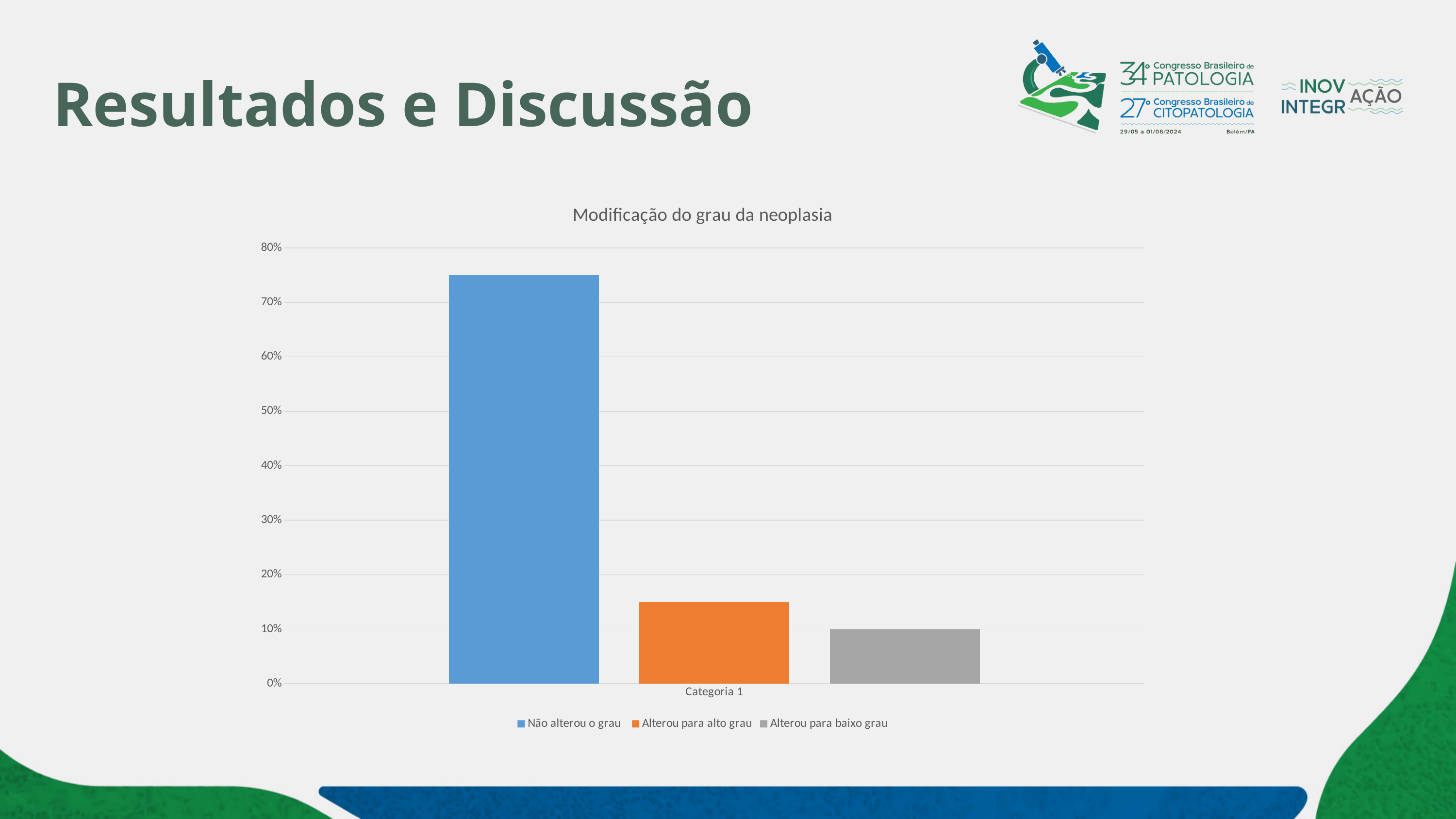
Is the value for Alterou para alto grau greater or less than 20%? less What is the title of the chart? Modificação do grau da neoplasia Is the value for Não alterou o grau greater or less than 70%? greater What is the value for Alterou para baixo grau? 10% What colour is the bar for Não alterou o grau? blue How many series does the legend list? 3 Which is larger, the value for Não alterou o grau or the value for Alterou para alto grau? Não alterou o grau Which series has the highest value? Não alterou o grau Which series has the lowest value? Alterou para baixo grau Which is larger, the value for Alterou para alto grau or the value for Alterou para baixo grau? Alterou para alto grau How many categories are shown on the x axis? 1 What kind of chart is shown on the slide? bar chart